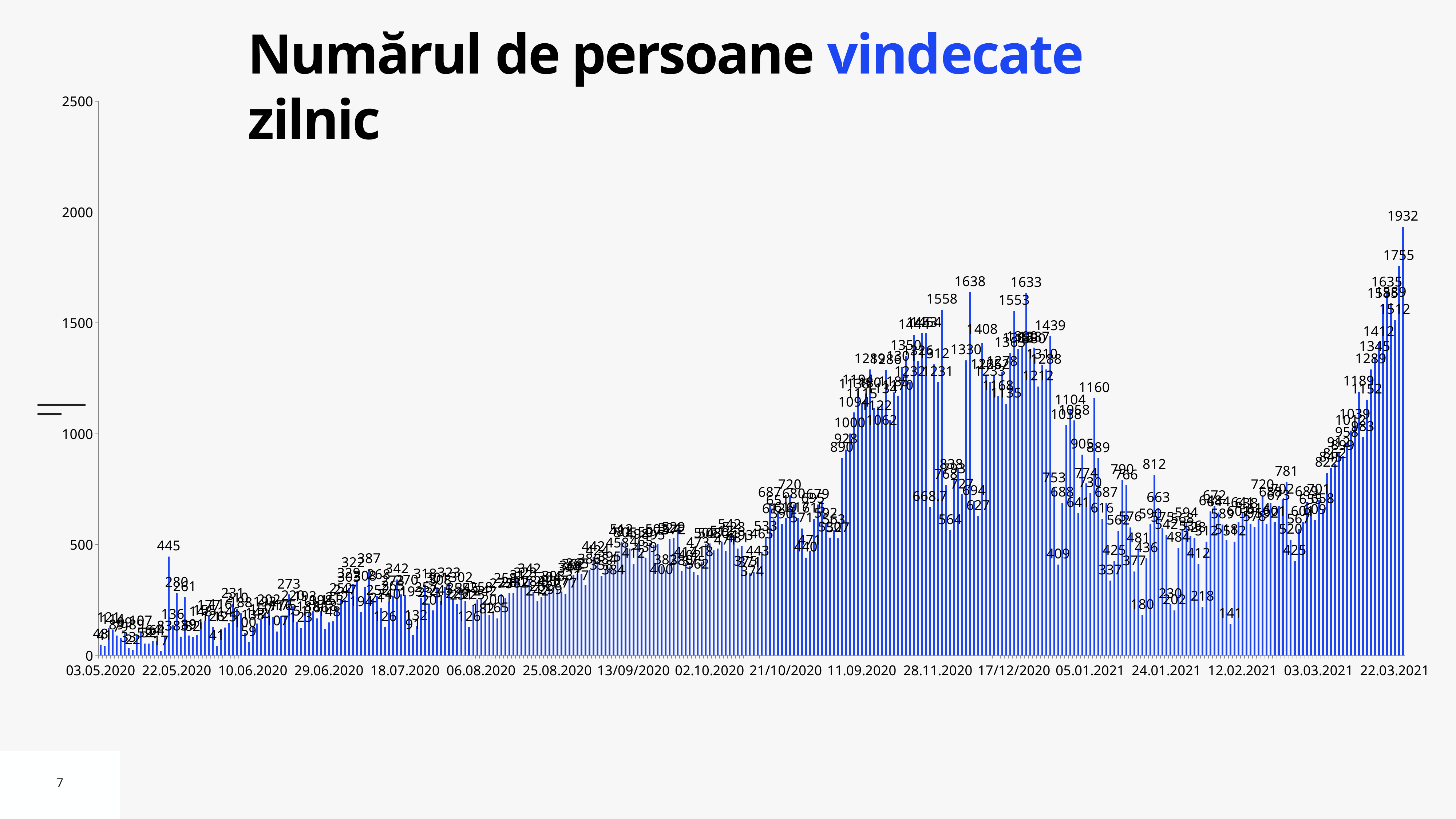
Is the value for the first bar (03.05.2020) greater or less than 500? less What is the value of the first bar, at 03.05.2020? 48 Is the value for the last bar (22.03.2021) greater or less than 1500? greater What is the difference between the two highest bars, 1932 and 1755? 177 What is the highest value shown on the chart? 1932 What is the value of the second-highest bar, just before the 1932 bar? 1755 Which is larger, the peak value of 1638 in late 2020 or the final peak of 1932 in March 2021? 1932 What kind of chart is shown on the slide? bar chart What is the maximum value shown on the vertical axis? 2500 Do the values generally rise or fall between 03.03.2021 and 22.03.2021? rise What is the title of the chart? Numărul de persoane vindecate zilnic What is the highest value reached during the November–December 2020 peak? 1638